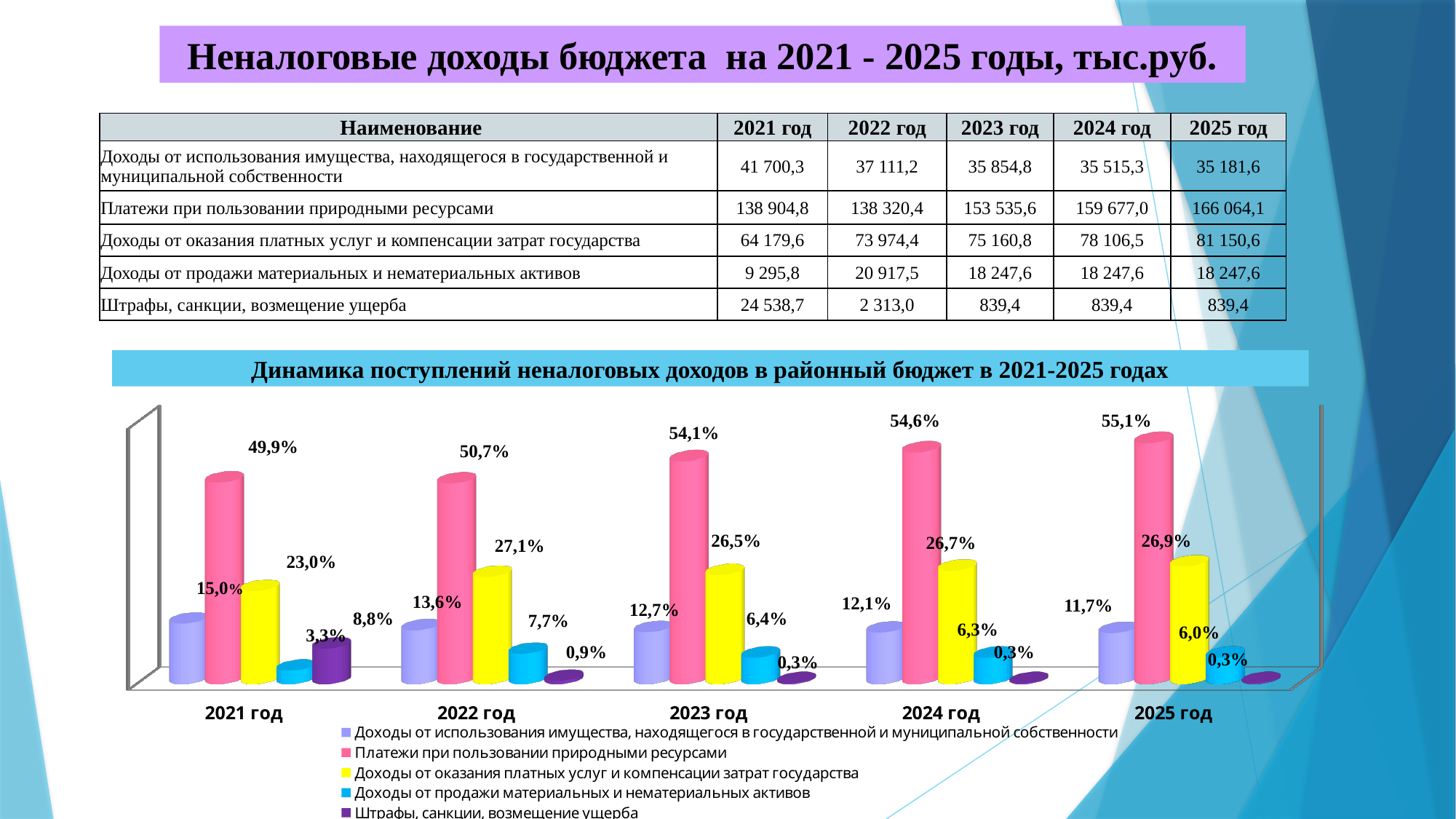
In the chart, what is the value for «Штрафы, санкции, возмещение ущерба» in 2021 год? 8,8% In the chart, which year has the highest value for «Платежи при пользовании природными ресурсами»? 2025 год In the chart, what is the value for «Доходы от продажи материальных и нематериальных активов» in 2025 год? 6,0% In the chart, what is the value for «Доходы от оказания платных услуг и компенсации затрат государства» in 2022 год? 27,1% What type of chart is shown under the title «Динамика поступлений неналоговых доходов в районный бюджет в 2021-2025 годах»? Bar chart In the chart, what is the difference between the «Платежи при пользовании природными ресурсами» values for 2025 год and 2021 год? 5,2% How many year categories are shown on the x axis of the chart? 5 In the chart, what is the value for «Платежи при пользовании природными ресурсами» in 2021 год? 49,9% In the chart, which is larger in 2023 год: «Доходы от оказания платных услуг и компенсации затрат государства» or «Доходы от использования имущества, находящегося в государственной и муниципальной собственности»? Доходы от оказания платных услуг и компенсации затрат государства In the chart, which year has the lowest value for «Доходы от использования имущества, находящегося в государственной и муниципальной собственности»? 2025 год In the chart, does the share of «Доходы от использования имущества, находящегося в государственной и муниципальной собственности» rise or fall from 2021 год to 2025 год? Fall How many series does the legend of the chart list? 5